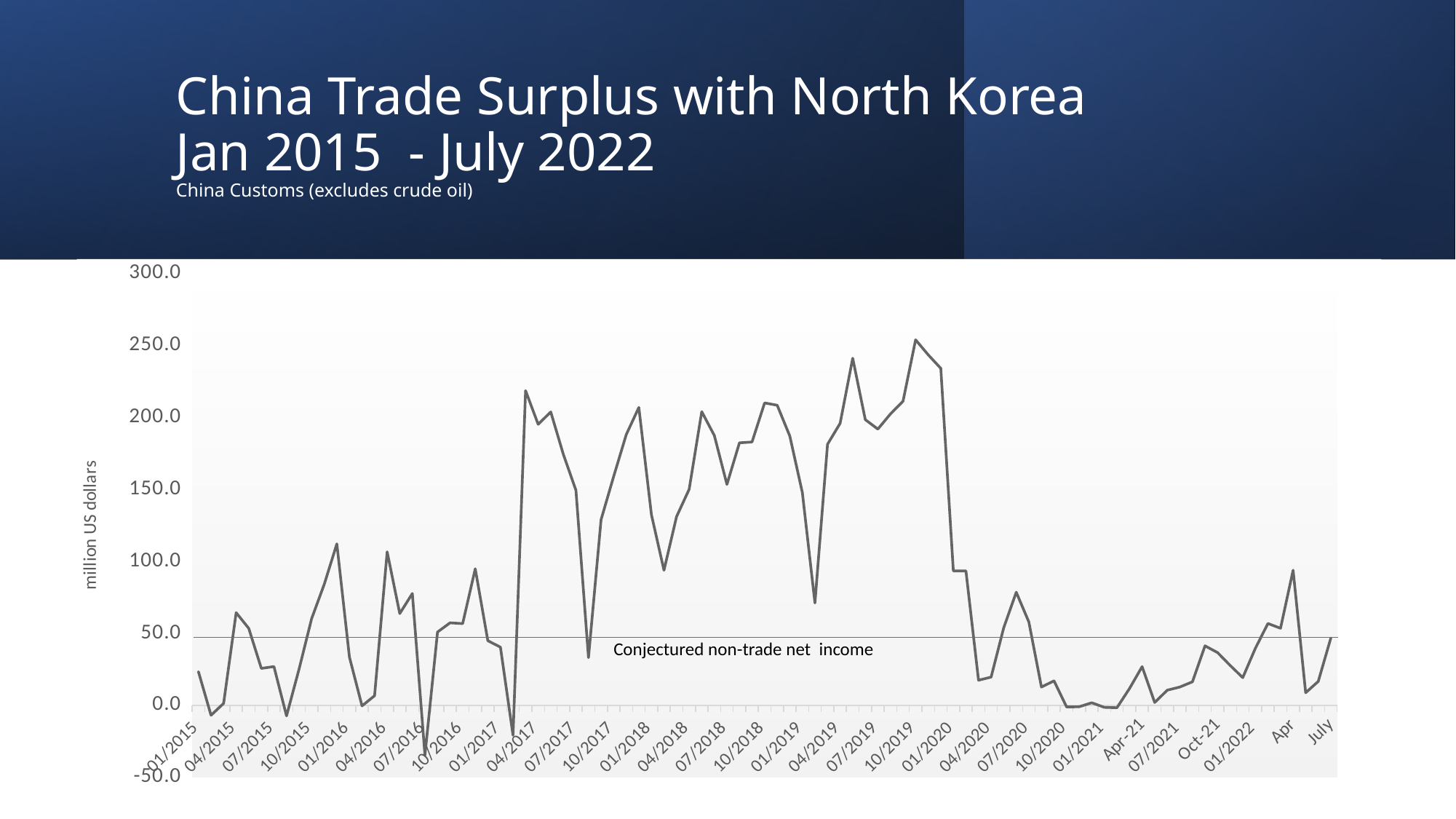
Between 01/2020 and 04/2020, does the trade surplus rise or fall? fall What unit is shown on the y-axis label of the chart? million US dollars Is the value for 07/2020 greater or less than 50? greater Is the value for 01/2019 greater or less than 100? greater Which is larger, the value for 04/2017 or the value for 04/2020? 04/2017 Which month shows the highest trade surplus value on the chart? 10/2019 What kind of chart is shown on the slide? line chart Is the value for 04/2020 greater or less than 50? less How many lines (data series) are plotted on the chart? 1 What is the title of the chart on the slide? China Trade Surplus with North Korea Jan 2015 - July 2022